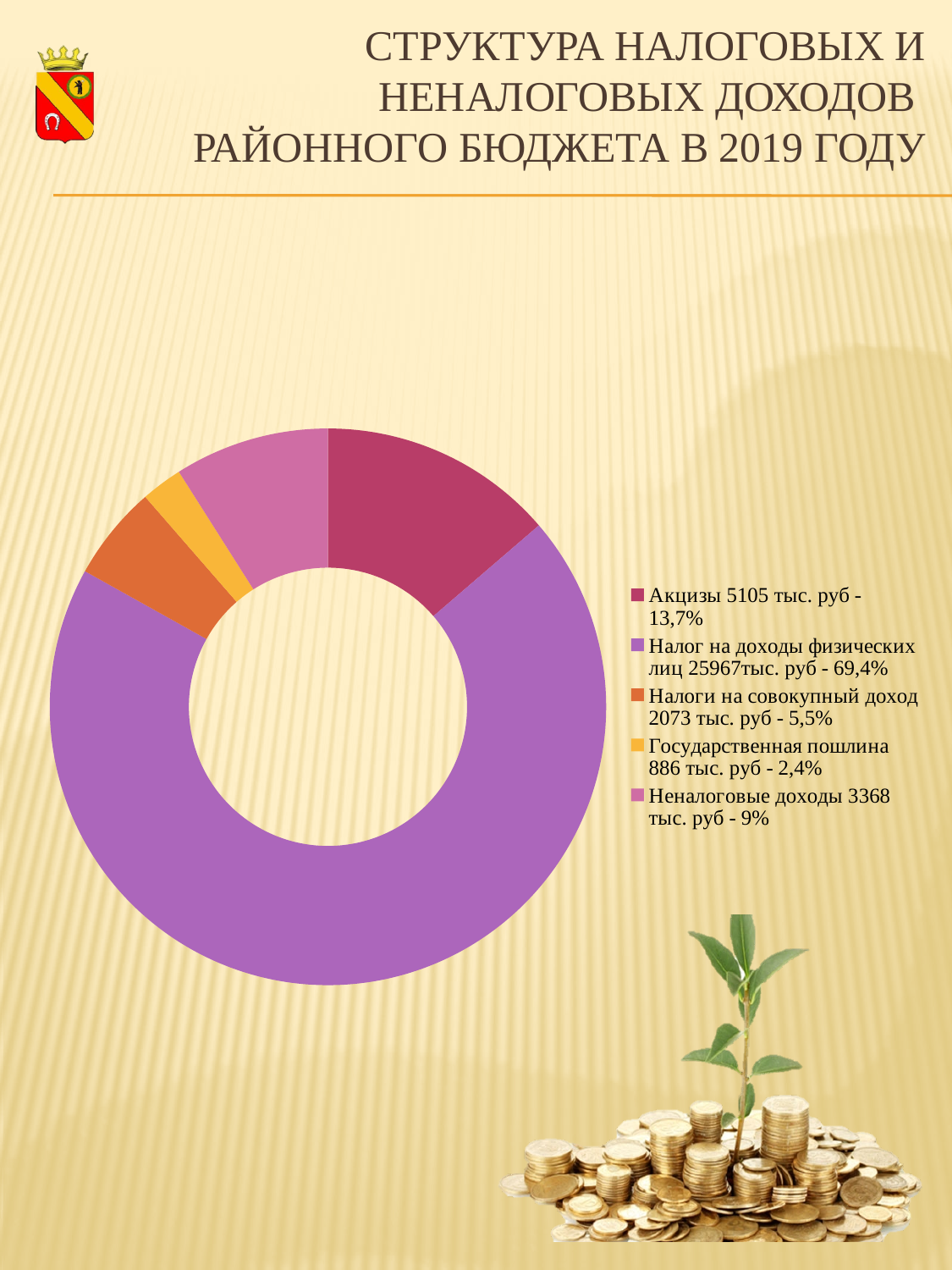
What is the value for Налоги на совокупный доход? 2073 тыс. руб What kind of chart is shown on the slide? Doughnut (pie) chart Which is larger, the value for Налоги на совокупный доход or the value for Государственная пошлина? Налоги на совокупный доход What share of the chart does Государственная пошлина represent? 2,4% How many categories does the chart's legend list? 5 What colour is the slice for Государственная пошлина? Yellow/orange Which category has the smallest share of the chart? Государственная пошлина What is the value for Неналоговые доходы? 3368 тыс. руб What is the difference in value between Акцизы and Неналоговые доходы? 1737 тыс. руб What share of the chart does Налог на доходы физических лиц represent? 69,4% What is the value for Акцизы? 5105 тыс. руб Which category has the largest share of the chart? Налог на доходы физических лиц